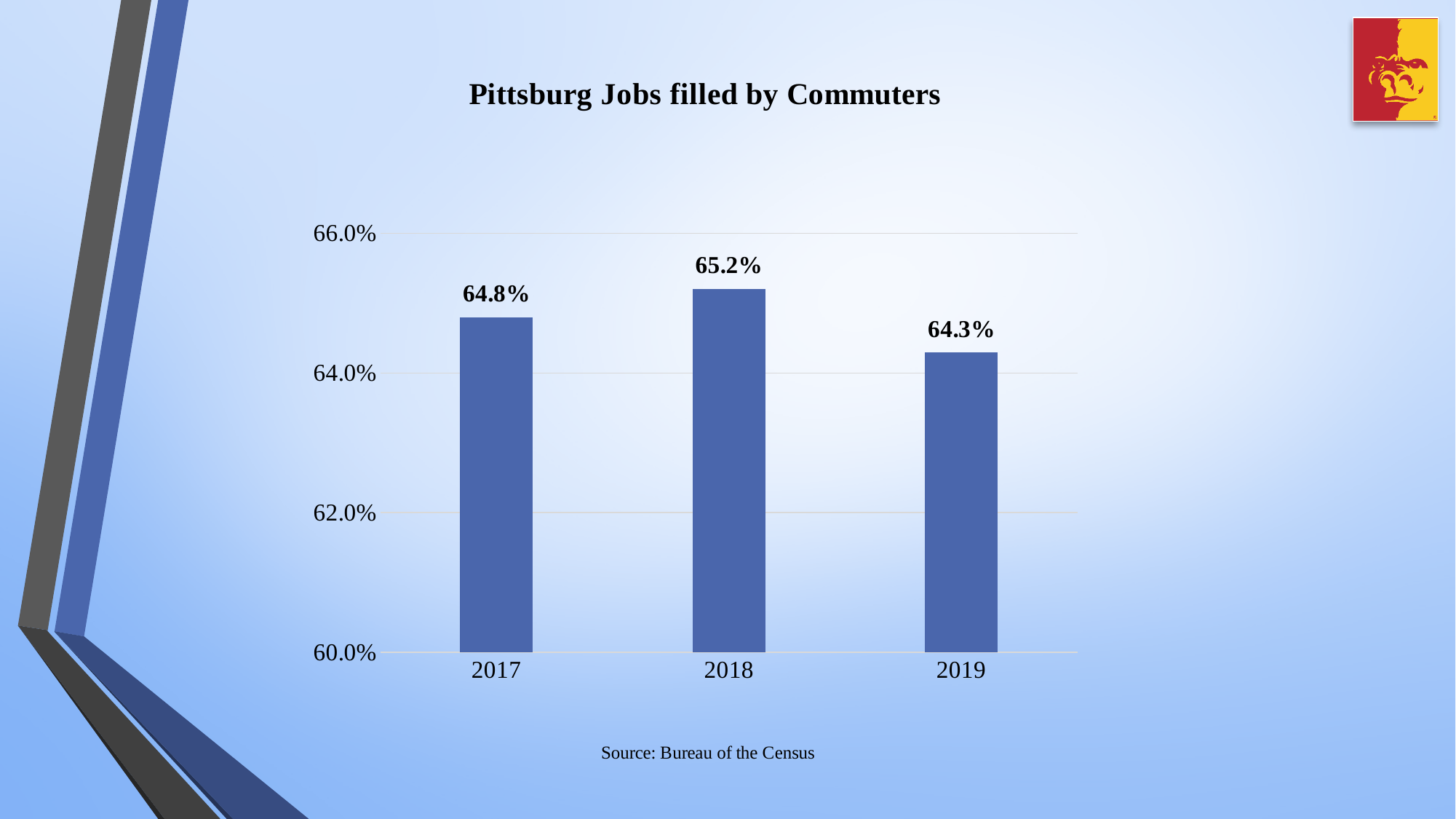
What percentage of Pittsburg jobs were filled by commuters in 2018? 65.2% Which year has a larger value, 2017 or 2019? 2017 What is the source cited below the chart? Bureau of the Census What percentage of Pittsburg jobs were filled by commuters in 2019? 64.3% What is the difference in percentage points between the 2018 and 2019 values? 0.9 How many years are shown on the chart? 3 What kind of chart is shown on the slide? Bar chart Which year has the lowest share of Pittsburg jobs filled by commuters? 2019 Which year has the highest share of Pittsburg jobs filled by commuters? 2018 What is the difference in percentage points between the 2017 and 2019 values? 0.5 Is the value for 2019 greater or less than 66.0%? less What percentage of Pittsburg jobs were filled by commuters in 2017? 64.8%